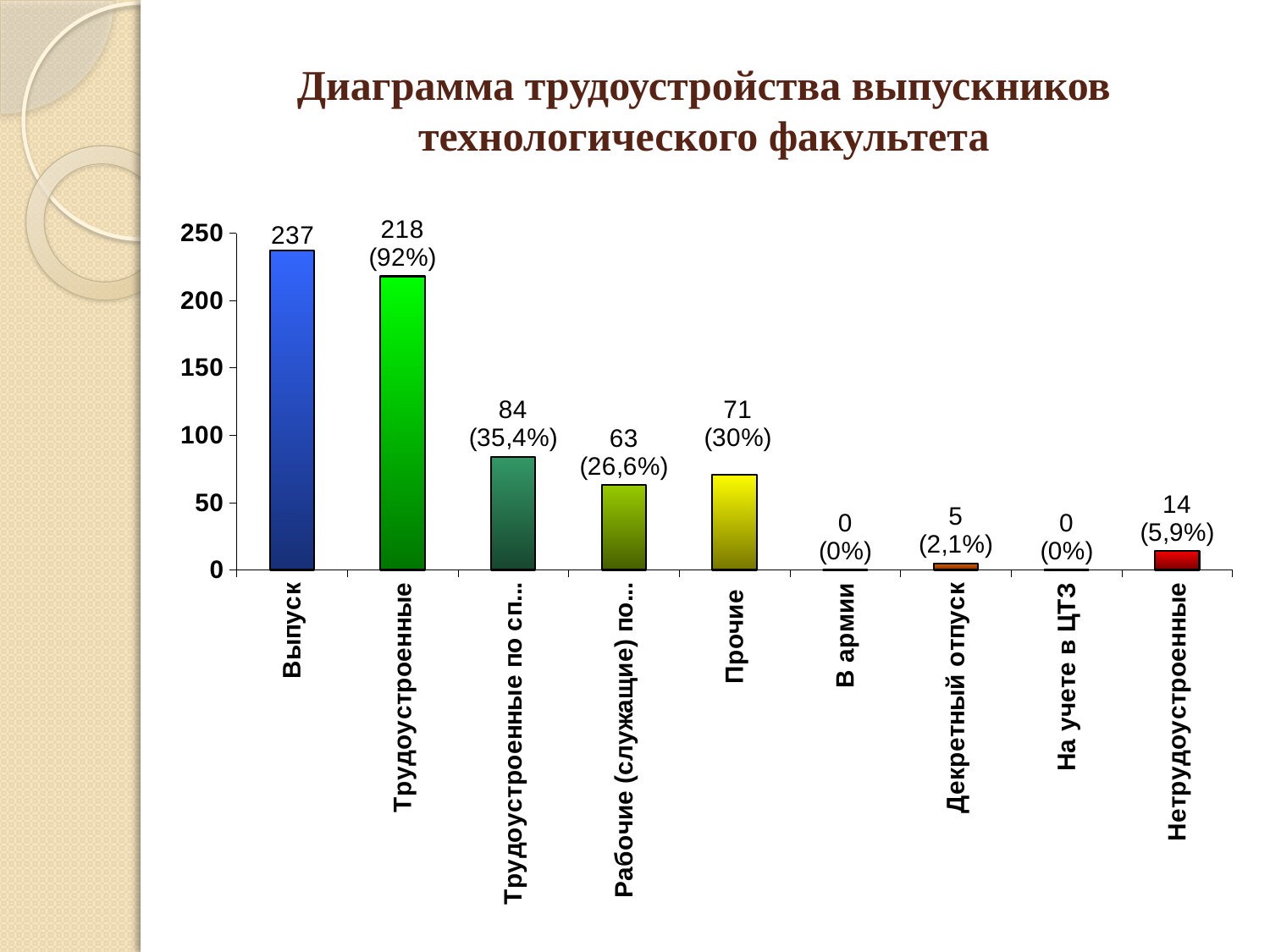
What is the difference between Выпуск and Трудоустроенные? 19 What is the value for Трудоустроенные? 218 Which category has the highest value? Выпуск How many categories are shown on the x axis? 9 What kind of chart is shown? bar chart What is the title of the slide? Диаграмма трудоустройства выпускников технологического факультета What percentage is shown for Нетрудоустроенные? 5,9% Is the value for Трудоустроенные greater or less than 200? greater Which is larger, Прочие or Нетрудоустроенные? Прочие What is the value for Декретный отпуск? 5 What is the value for Выпуск? 237 What is the value for Прочие? 71